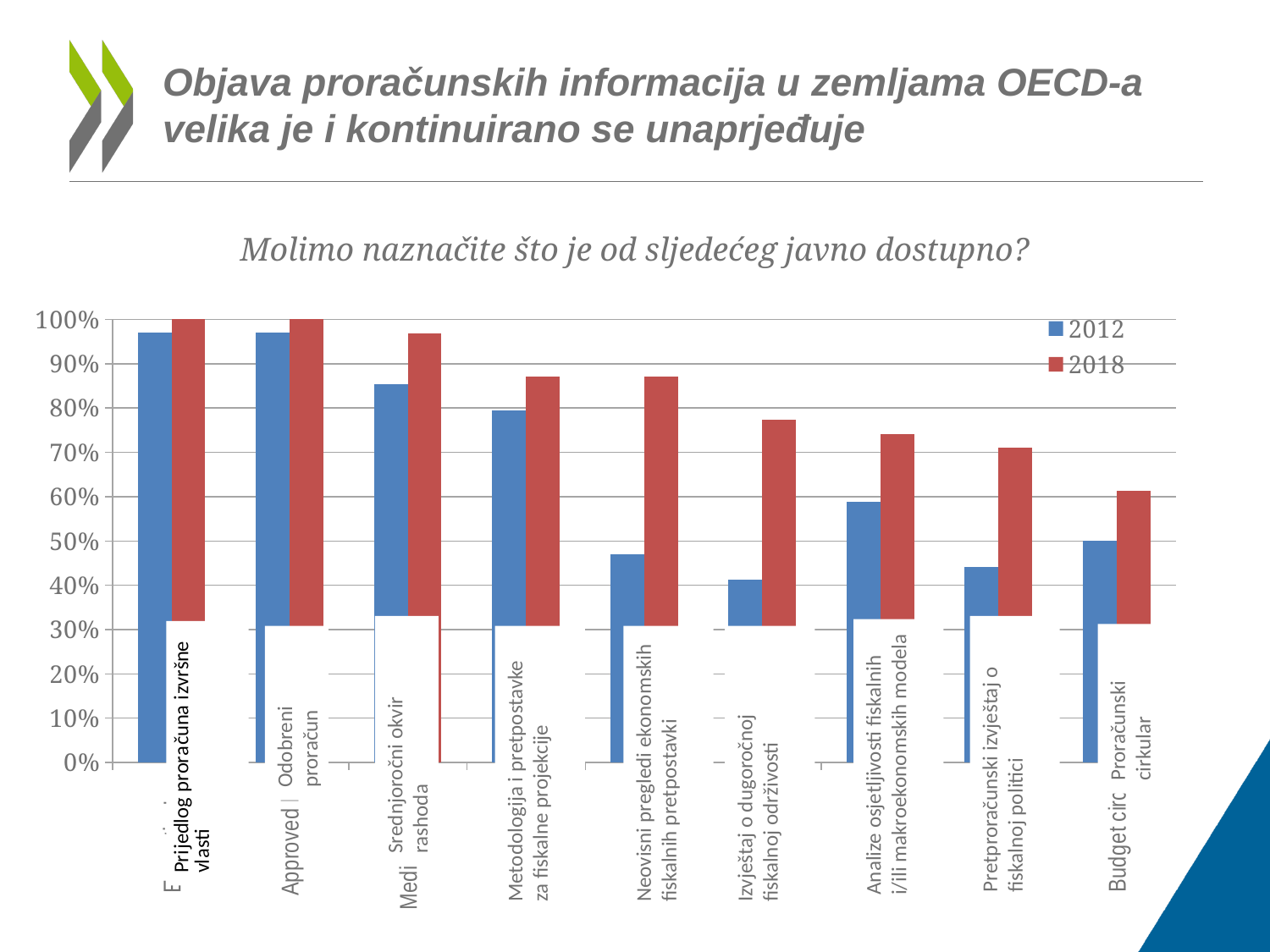
Which is larger: the 2012 value for Metodologija i pretpostavke za fiskalne projekcije or the 2012 value for Neovisni pregledi ekonomskih fiskalnih pretpostavki? Metodologija i pretpostavke za fiskalne projekcije How many series does the legend list? 2 How many categories are shown on the x axis? 9 Is the 2018 value for Proračunski cirkular greater or less than 50%? greater Which category has the lowest 2018 value? Proračunski cirkular Is the 2012 value for Neovisni pregledi ekonomskih fiskalnih pretpostavki greater or less than 50%? less What is the 2018 value for Odobreni proračun? 100% What kind of chart is shown on the slide? bar chart Which years are listed in the legend? 2012 and 2018 For each category, is the 2018 bar higher or lower than the 2012 bar? higher Do the 2018 values generally rise or fall from left to right along the x axis? fall Is the 2012 value for Srednjoročni okvir rashoda greater or less than 80%? greater